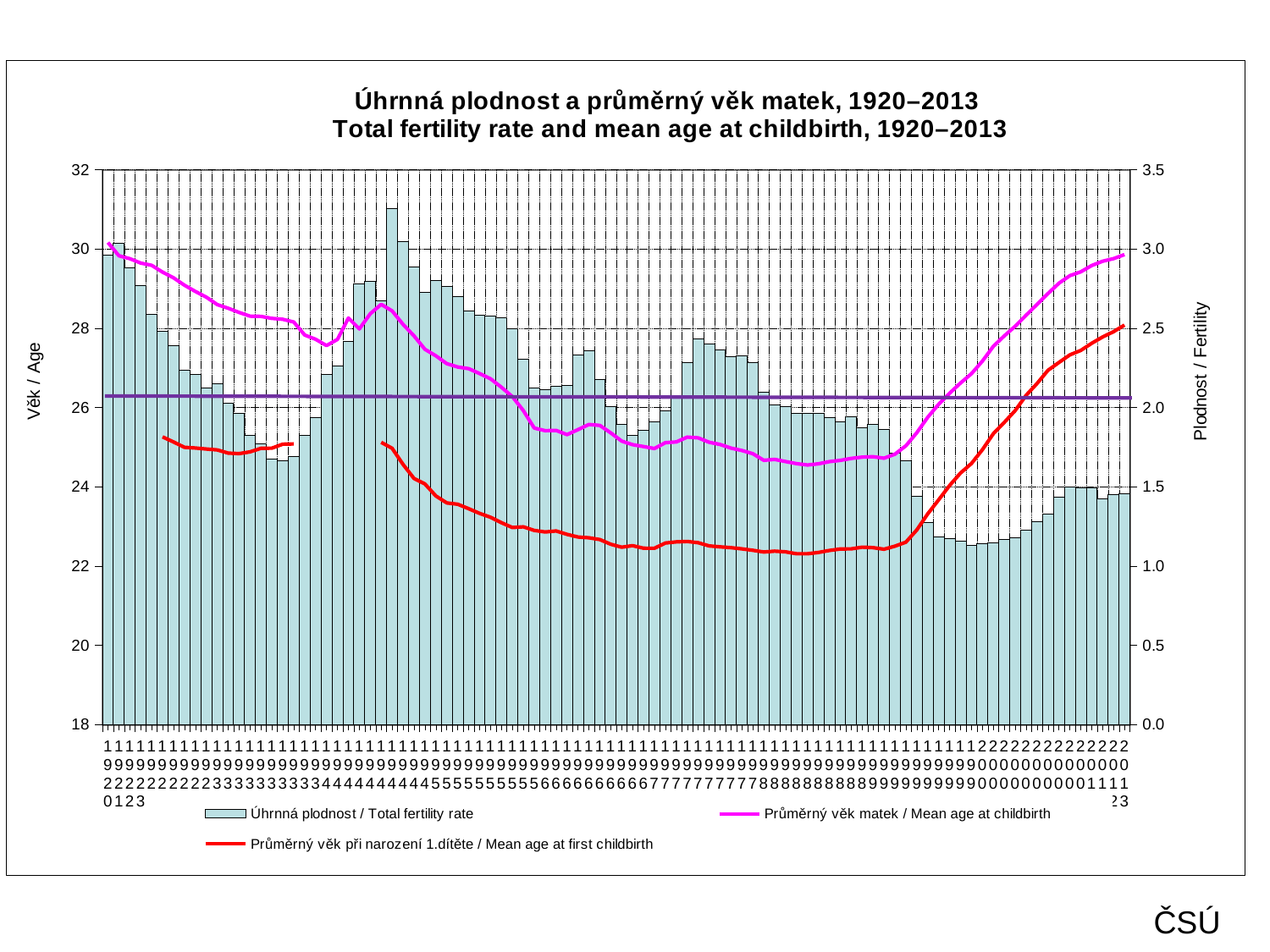
What kind of chart is shown on the slide? A combined bar and line chart Does the mean age at childbirth rise or fall between 1920 and 1990? fall Does the mean age at childbirth rise or fall between 1990 and 2013? rise Is the mean age at first childbirth (red line) in 2013 greater or less than 26? greater Is the mean age at childbirth (magenta line) in 2013 greater or less than 28? greater Is the total fertility rate in 2013 greater or less than 2.0? less Which series is drawn as bars? Úhrnná plodnost / Total fertility rate In 2013, which is higher: the mean age at childbirth or the mean age at first childbirth? Mean age at childbirth How many series does the legend list? 3 What is the title of the chart in English? Total fertility rate and mean age at childbirth, 1920–2013